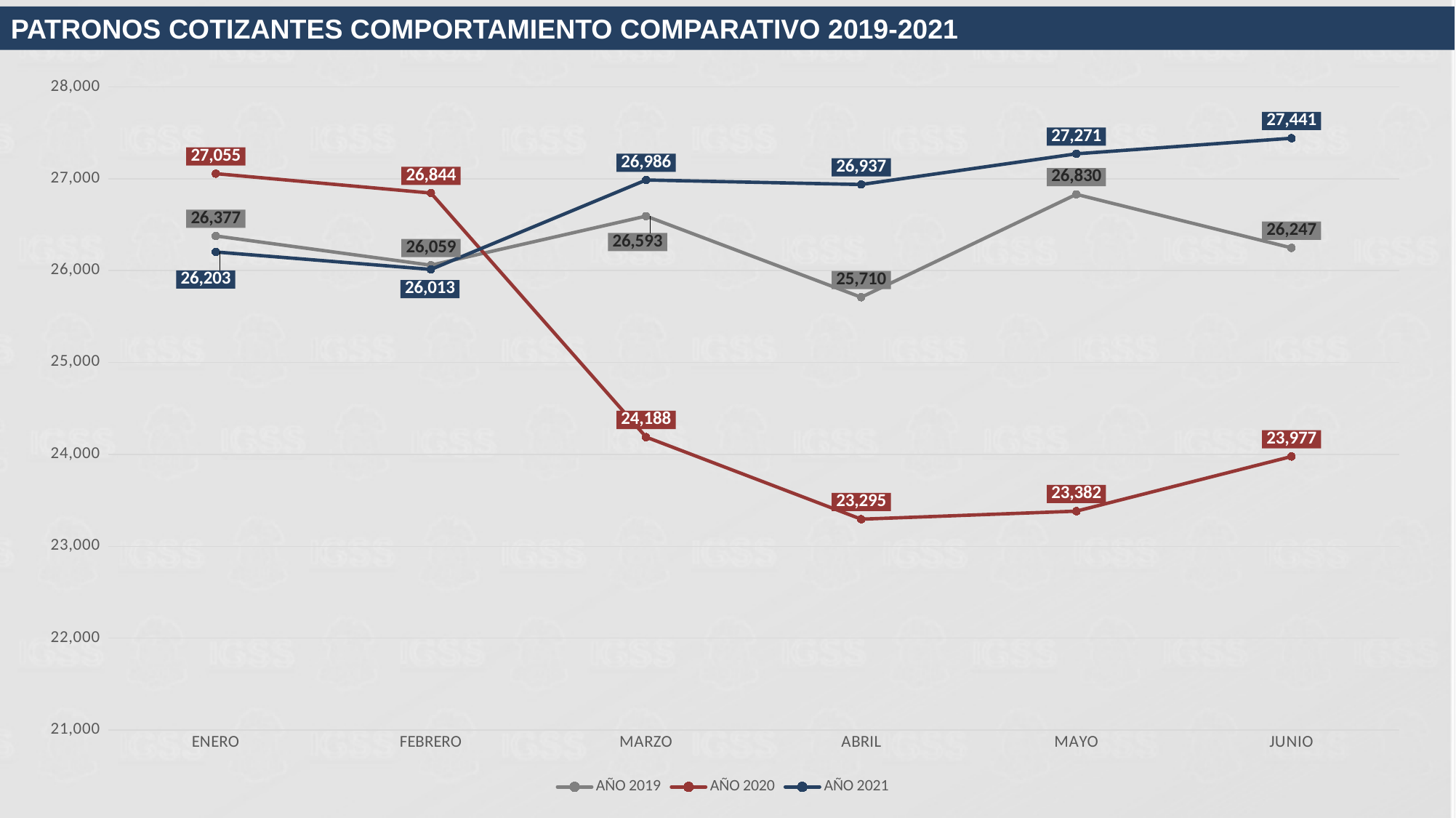
What is the difference between the AÑO 2021 and AÑO 2020 values in JUNIO? 3,464 Which series has the larger value in ENERO, AÑO 2019 or AÑO 2020? AÑO 2020 In which month is the AÑO 2021 value highest? JUNIO Does the AÑO 2020 series rise or fall from ENERO to ABRIL? Fall What is the value for AÑO 2021 in JUNIO? 27,441 How many series does the legend list? 3 What kind of chart is shown on the slide? Line chart How many months are shown on the x axis? 6 What is the value for AÑO 2020 in ABRIL? 23,295 What is the value for AÑO 2019 in MAYO? 26,830 In which month is the AÑO 2020 value lowest? ABRIL What is the title of the chart? PATRONOS COTIZANTES COMPORTAMIENTO COMPARATIVO 2019-2021